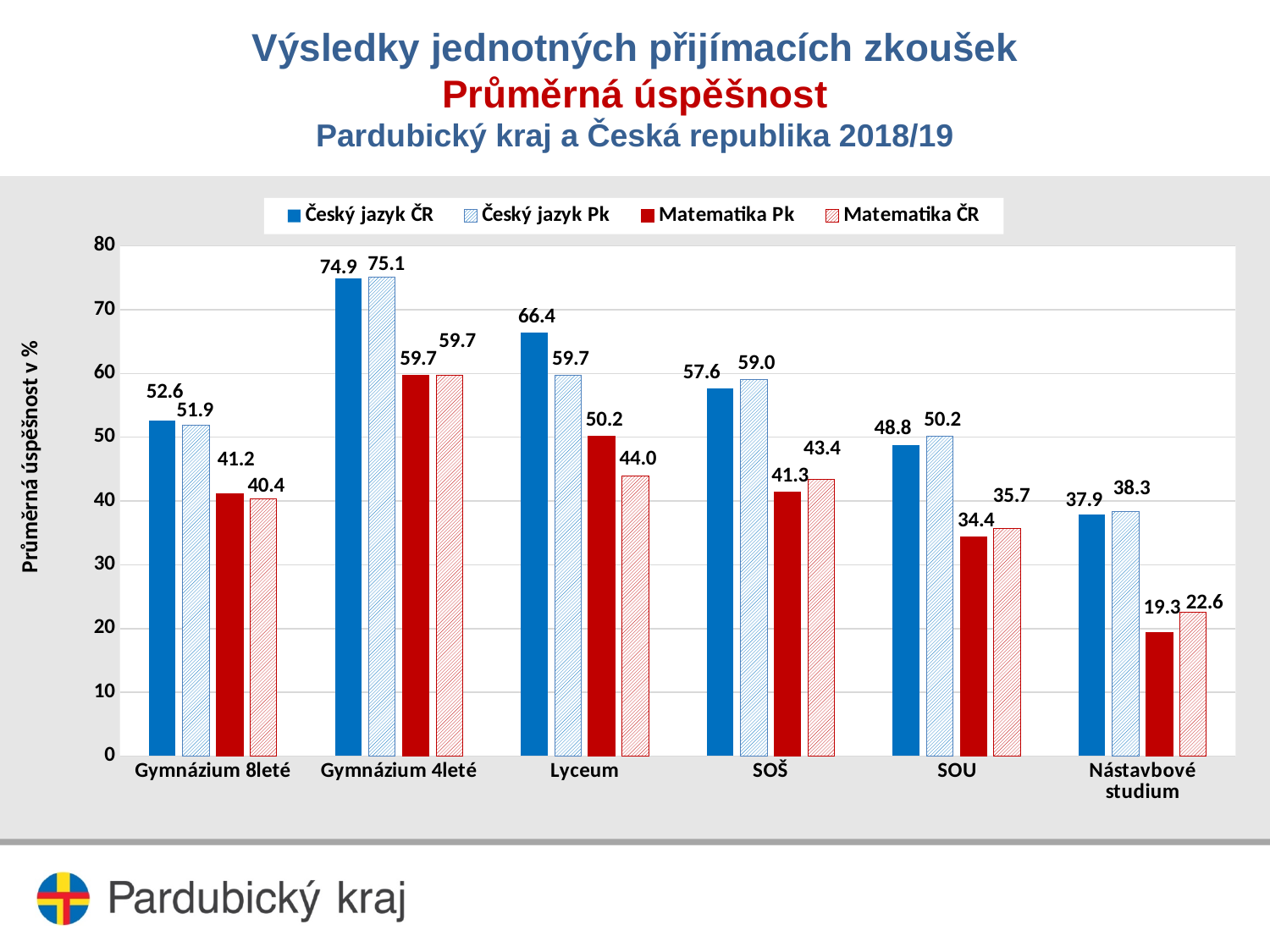
Which category has the lowest value for Matematika ČR? Nástavbové studium What is the label of the vertical axis? Průměrná úspěšnost v % Which is larger for SOU: Český jazyk Pk or Matematika ČR? Český jazyk Pk What is the value for Český jazyk ČR for Gymnázium 4leté? 74.9 What is the value for Matematika ČR for Lyceum? 44.0 How many series does the legend list? 4 Is the value for Matematika Pk for Gymnázium 8leté greater or less than 50? less What kind of chart is shown on the slide? bar chart How many categories are shown on the x axis? 6 What is the difference between Český jazyk ČR and Matematika Pk for SOŠ? 16.3 Which category has the highest value for Český jazyk Pk? Gymnázium 4leté What is the value for Matematika Pk for Nástavbové studium? 19.3